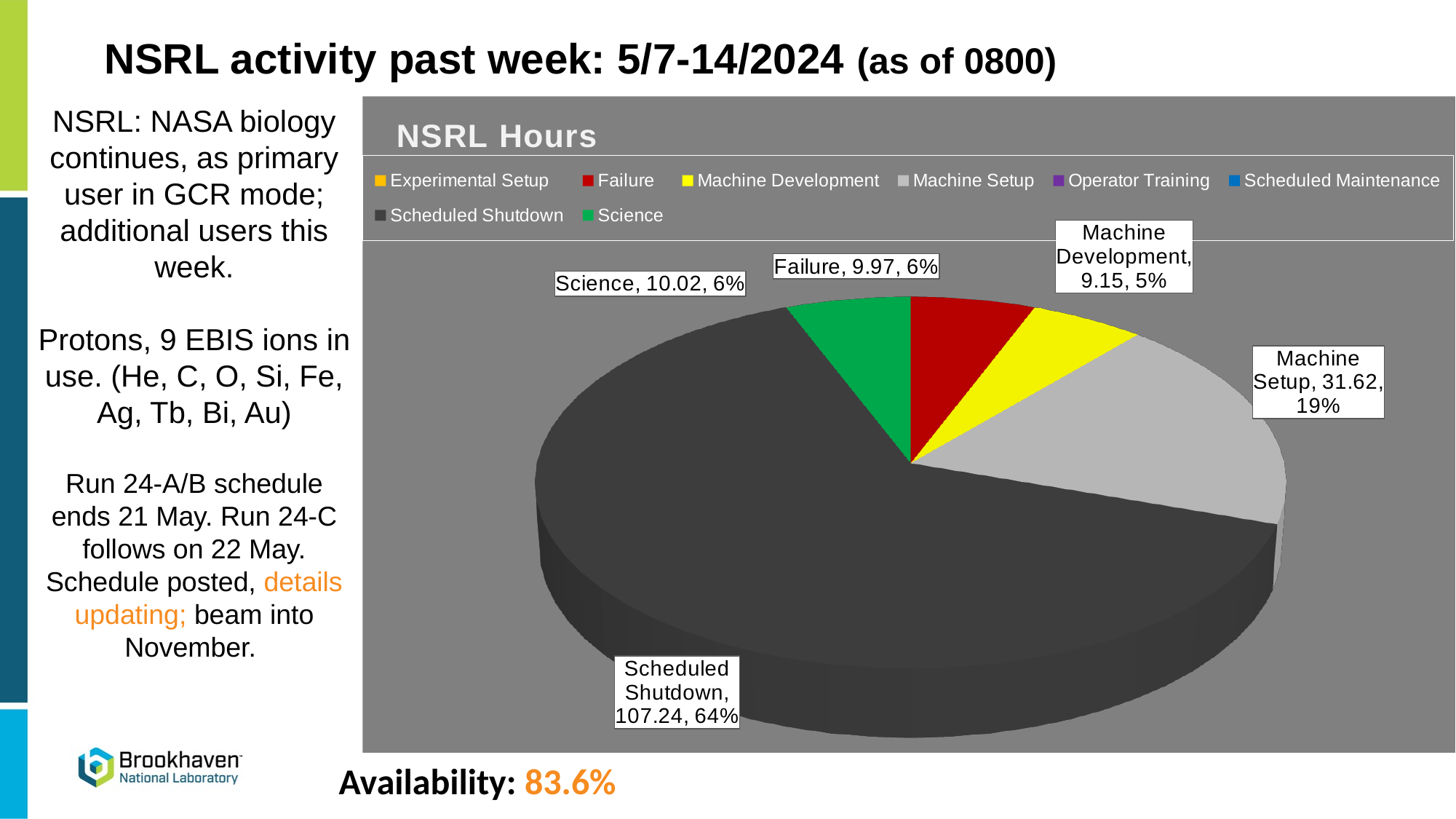
What is the difference in hours between Machine Setup and Science? 21.60 Which has more hours, Failure or Machine Development? Failure What share of the pie does Science represent? 6% Which labelled category has the smallest slice of the pie? Machine Development How many hours are shown for Scheduled Shutdown? 107.24 How many entries does the legend of the NSRL Hours chart list? 8 What share of the pie does Machine Setup represent? 19% What is the title of the chart? NSRL Hours How many hours are shown for Machine Setup? 31.62 How many hours are shown for Machine Development? 9.15 Which category has the largest slice of the pie? Scheduled Shutdown What kind of chart is the NSRL Hours chart? pie chart